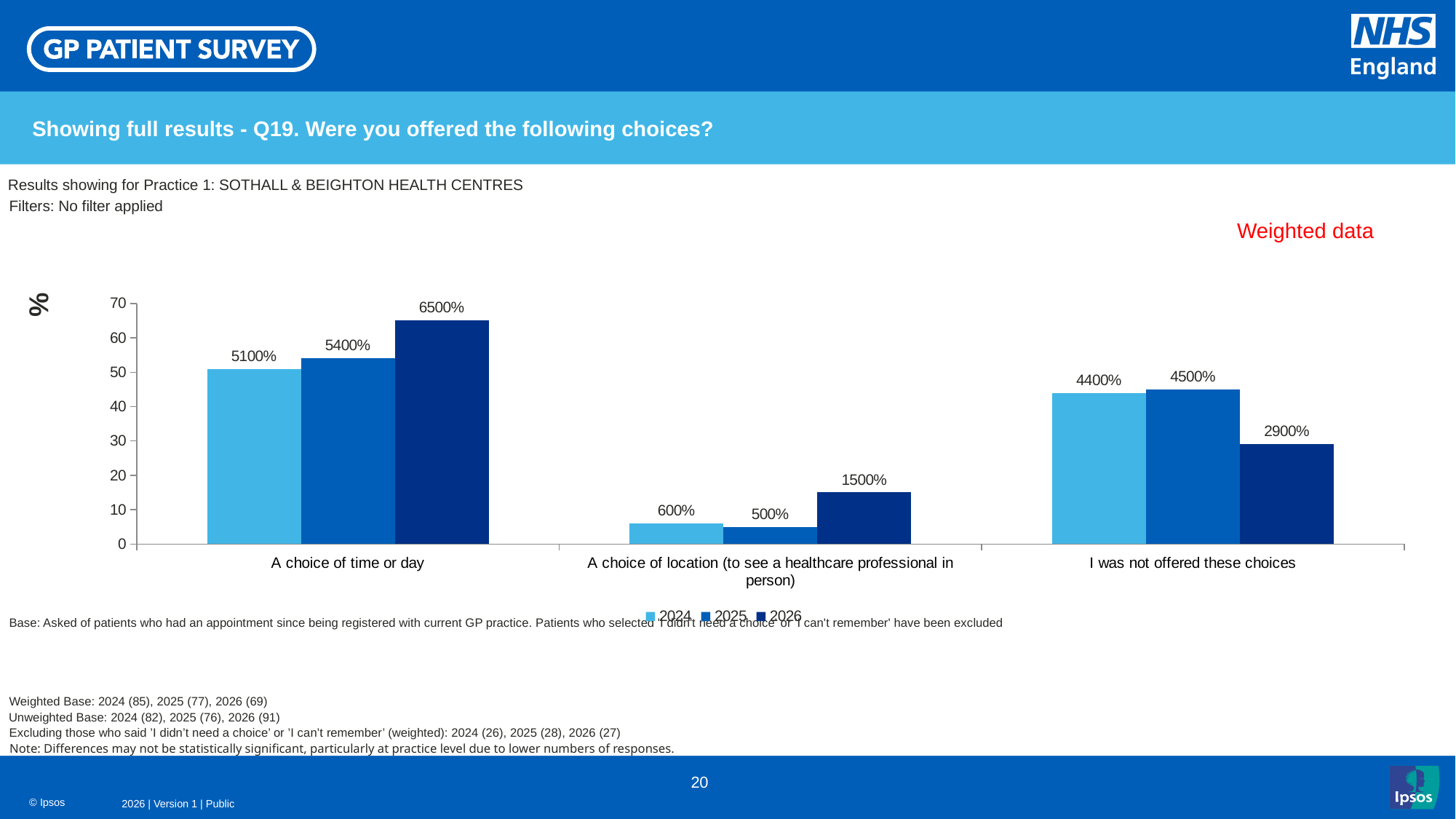
Is the 2026 value for 'A choice of time or day' larger or smaller than the 2026 value for 'I was not offered these choices'? larger What is the data label for 2026 in the 'A choice of time or day' category? 6500% What kind of chart is shown on the slide? bar chart Which series is shown in the darkest blue in the legend? 2026 Which category has the lowest values overall? A choice of location (to see a healthcare professional in person) Which year has the lowest value in the 'I was not offered these choices' category? 2026 What is the data label for 2025 in the 'I was not offered these choices' category? 4500% How many categories are shown on the x axis? 3 How many series does the legend list? 3 What is the data label for 2024 in the 'A choice of location (to see a healthcare professional in person)' category? 600% Do the values for 'A choice of time or day' rise or fall from 2024 to 2026? rise Which year has the highest value in the 'A choice of time or day' category? 2026